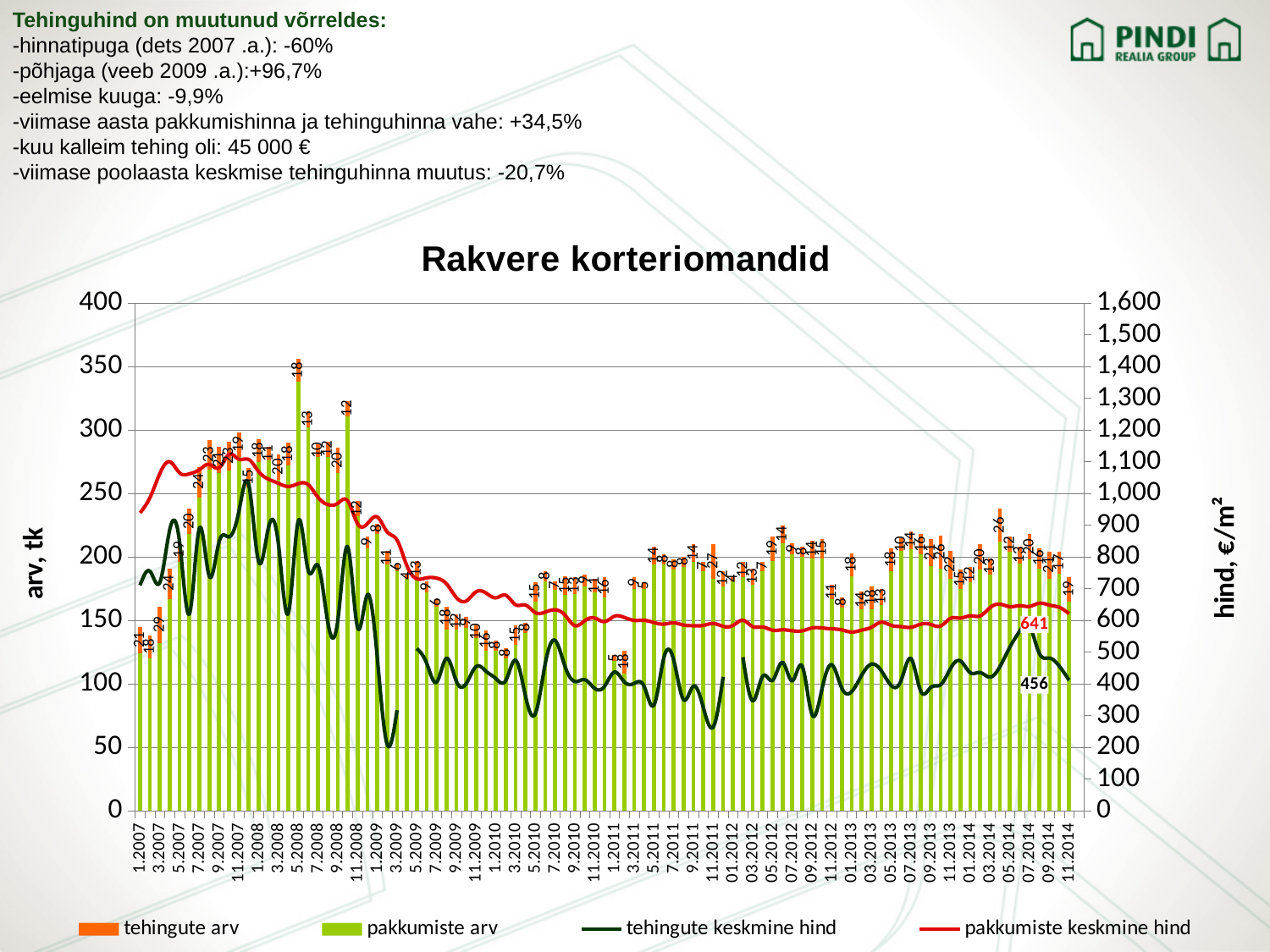
What value is labelled at the end of the pakkumiste keskmine hind line? 641 At the end of the chart, which is higher: pakkumiste keskmine hind or tehingute keskmine hind? pakkumiste keskmine hind What value is labelled at the end of the tehingute keskmine hind line? 456 In which month is the pakkumiste arv bar the highest? 5.2008 What is the title of the chart? Rakvere korteriomandid What is the difference between the labelled end values of pakkumiste keskmine hind (641) and tehingute keskmine hind (456)? 185 What is the label of the left vertical axis? arv, tk Is the pakkumiste arv bar for 1.2007 greater or less than 150? less What kind of chart is shown on the slide? Combined bar and line chart Is the pakkumiste arv bar for 5.2008 greater or less than 300? greater How many series does the chart legend list? 4 Does the pakkumiste keskmine hind line overall rise or fall from 1.2007 to 11.2014? fall